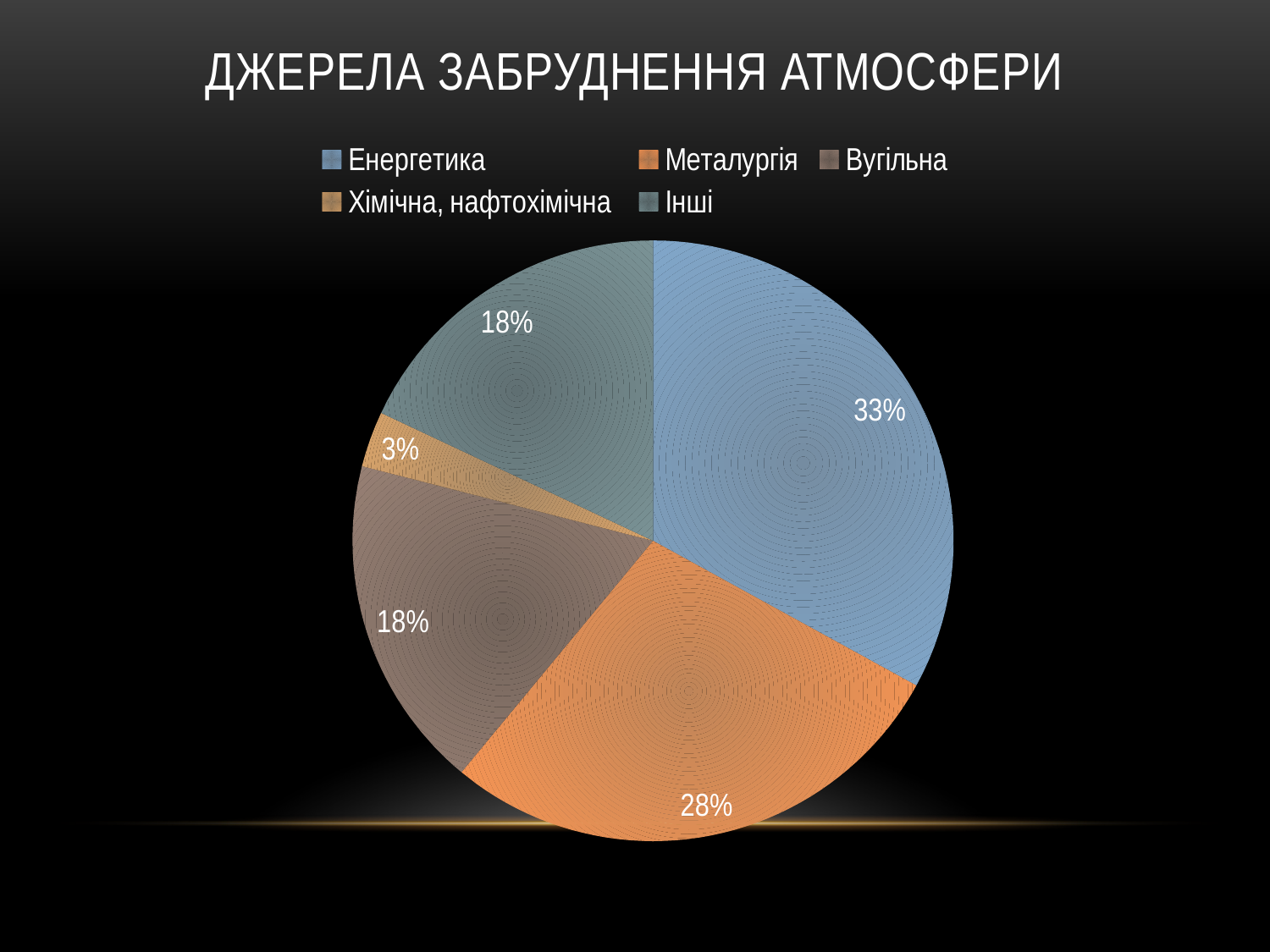
What type of chart is shown on the slide? Pie chart Which category has the largest share of the pie? Енергетика What share of the pie does Хімічна, нафтохімічна have? 3% What is the difference in percentage points between Енергетика and Металургія? 5 What share of the pie does Вугільна have? 18% What share of the pie does Металургія have? 28% What is the title of the chart? ДЖЕРЕЛА ЗАБРУДНЕННЯ АТМОСФЕРИ Which legend entry is shown in orange? Металургія Which category has the smallest share of the pie? Хімічна, нафтохімічна How many categories does the legend list? 5 Which is larger, the share for Металургія or the share for Вугільна? Металургія